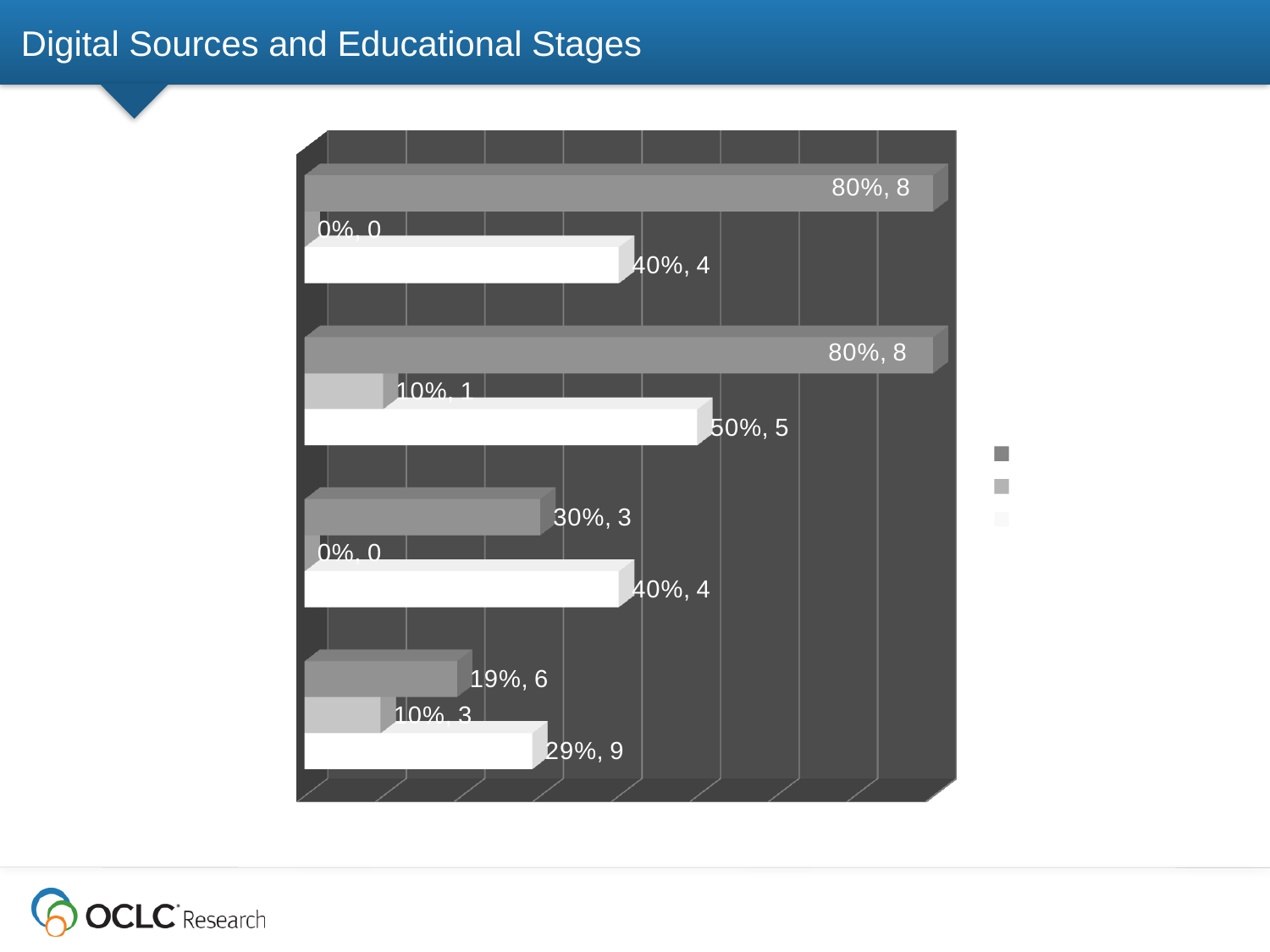
In the second group from the top, how much larger is the count on the dark grey bar than the count on the white bar? 3 What is the title of the slide containing the chart? Digital Sources and Educational Stages In the bottom group, which bar has the larger percentage, the dark grey bar or the white bar? the white bar What is the data label on the white bar in the third group from the top? 40%, 4 What is the data label on the light grey bar in the second group from the top? 10%, 1 What is the data label on the dark grey bar in the top group? 80%, 8 How many groups of bars does the chart show? 4 How many series does the legend list? 3 What kind of chart is shown on the slide? bar chart What is the data label on the white bar in the bottom group? 29%, 9 What is the highest percentage shown on any bar in the chart? 80% What is the lowest data label shown in the chart? 0%, 0